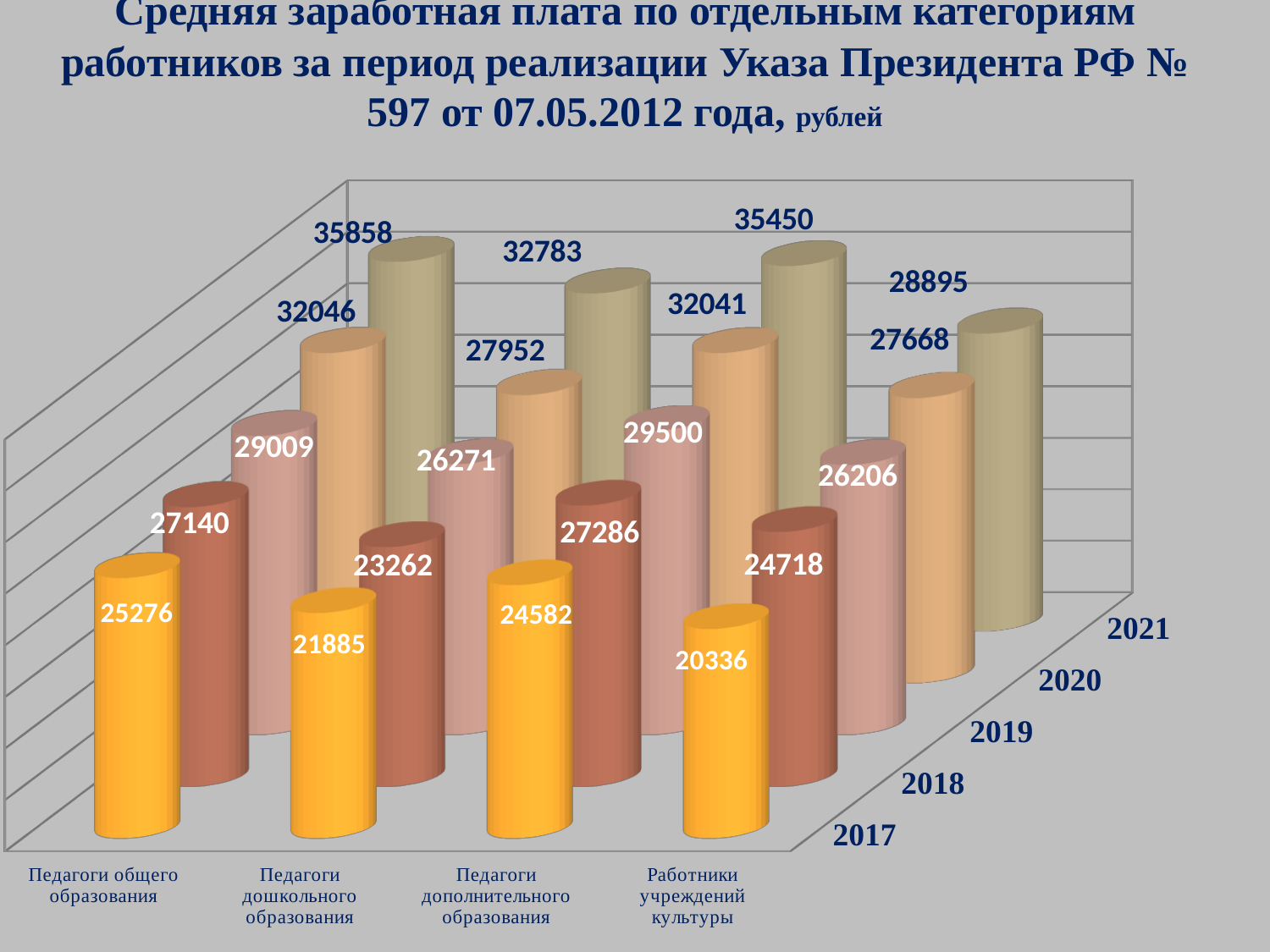
Which was larger in 2018: the salary of Педагоги дошкольного образования or Работники учреждений культуры? Работники учреждений культуры What is the difference between the 2021 salaries of Педагоги дополнительного образования and Работники учреждений культуры? 6555 Which category had the lowest average salary in 2017? Работники учреждений культуры Which category had the highest average salary in 2021? Педагоги общего образования Did the average salary of Работники учреждений культуры rise or fall from 2017 to 2021? rise How many worker categories are shown on the chart? 4 What was the average salary of Работники учреждений культуры in 2017? 20336 What was the average salary of Педагоги дошкольного образования in 2019? 26271 What was the average salary of Педагоги дополнительного образования in 2020? 32041 How many years are shown on the chart? 5 By how much did the average salary of Педагоги общего образования in 2021 exceed that of 2017? 10582 What was the average salary of Педагоги общего образования in 2021? 35858